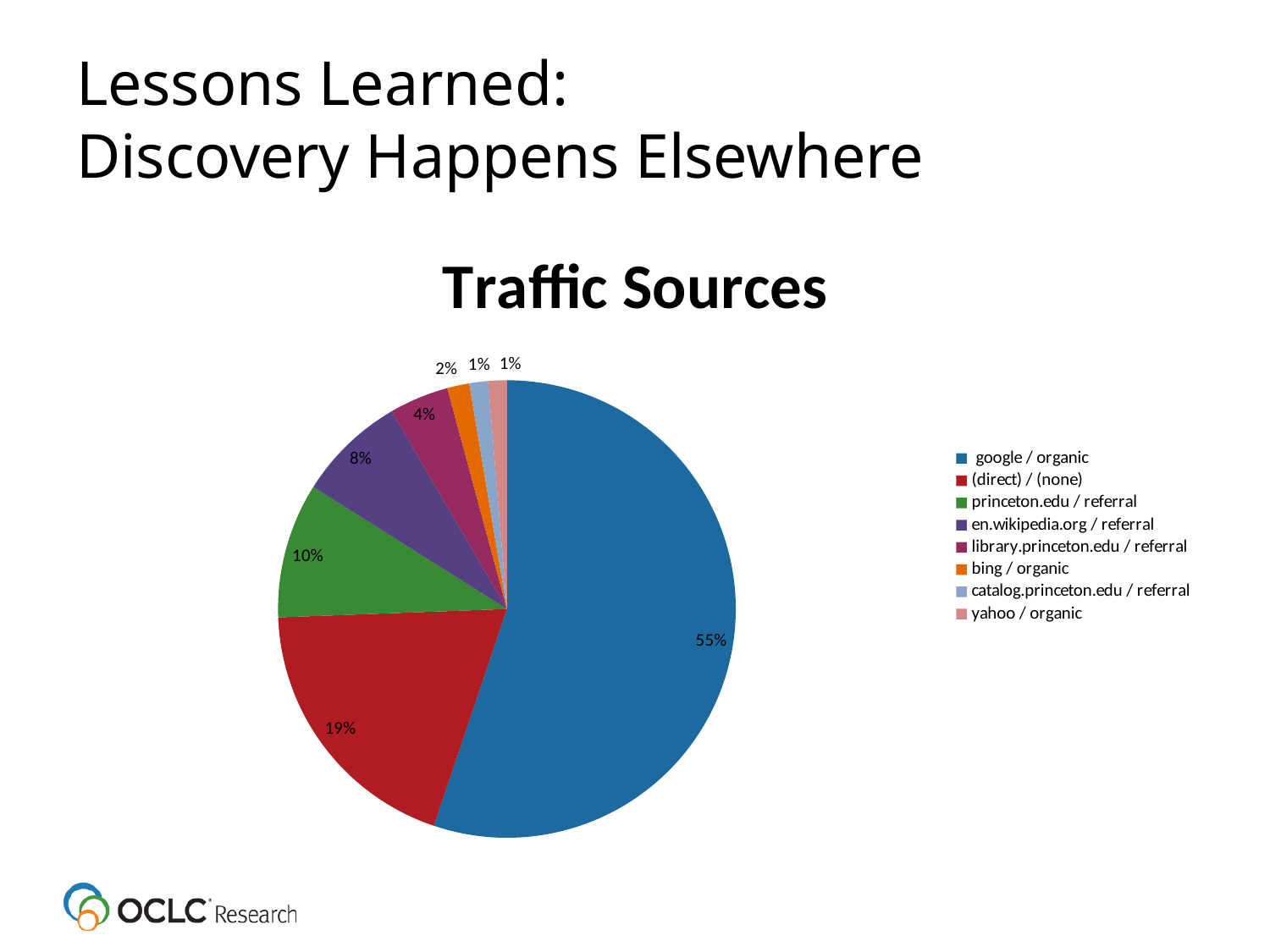
What is the title of the chart? Traffic Sources What share of traffic comes from bing / organic? 2% Which traffic source has the largest share? google / organic What share of traffic comes from princeton.edu / referral? 10% What share of traffic comes from google / organic? 55% What share of traffic comes from en.wikipedia.org / referral? 8% What share of traffic comes from (direct) / (none)? 19% Which is larger, the share for princeton.edu / referral or the share for en.wikipedia.org / referral? princeton.edu / referral What colour is the slice for (direct) / (none)? red How many traffic sources does the legend list? 8 What is the difference between the google / organic share and the (direct) / (none) share? 36% What kind of chart is shown on the slide? pie chart